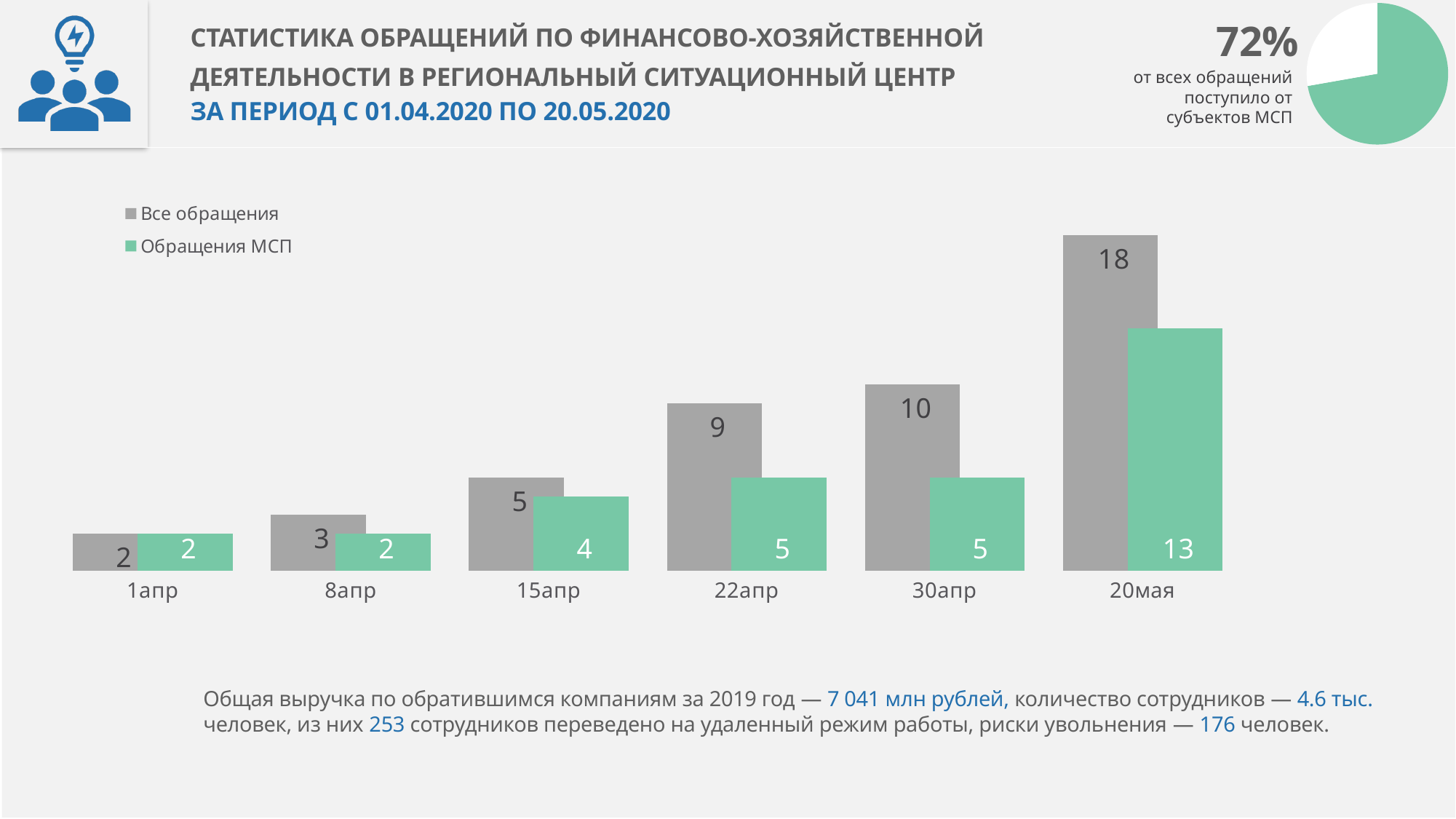
How many series does the legend of the bar chart list? 2 What kind of chart shows the appeals by date? Bar chart What is the value for "Все обращения" on 22апр? 9 What is the difference between "Все обращения" on 30апр and on 22апр? 1 Which date has the highest value for "Все обращения"? 20мая What is the difference between "Все обращения" and "Обращения МСП" on 20мая? 5 Which date has the lowest value for "Все обращения"? 1апр What is the value for "Обращения МСП" on 15апр? 4 Do the values for "Все обращения" rise or fall from 1апр to 20мая? Rise What is the value for "Все обращения" on 20мая? 18 Which is larger: "Обращения МСП" on 20мая or "Все обращения" on 30апр? "Обращения МСП" on 20мая How many dates are shown on the x axis of the bar chart? 6